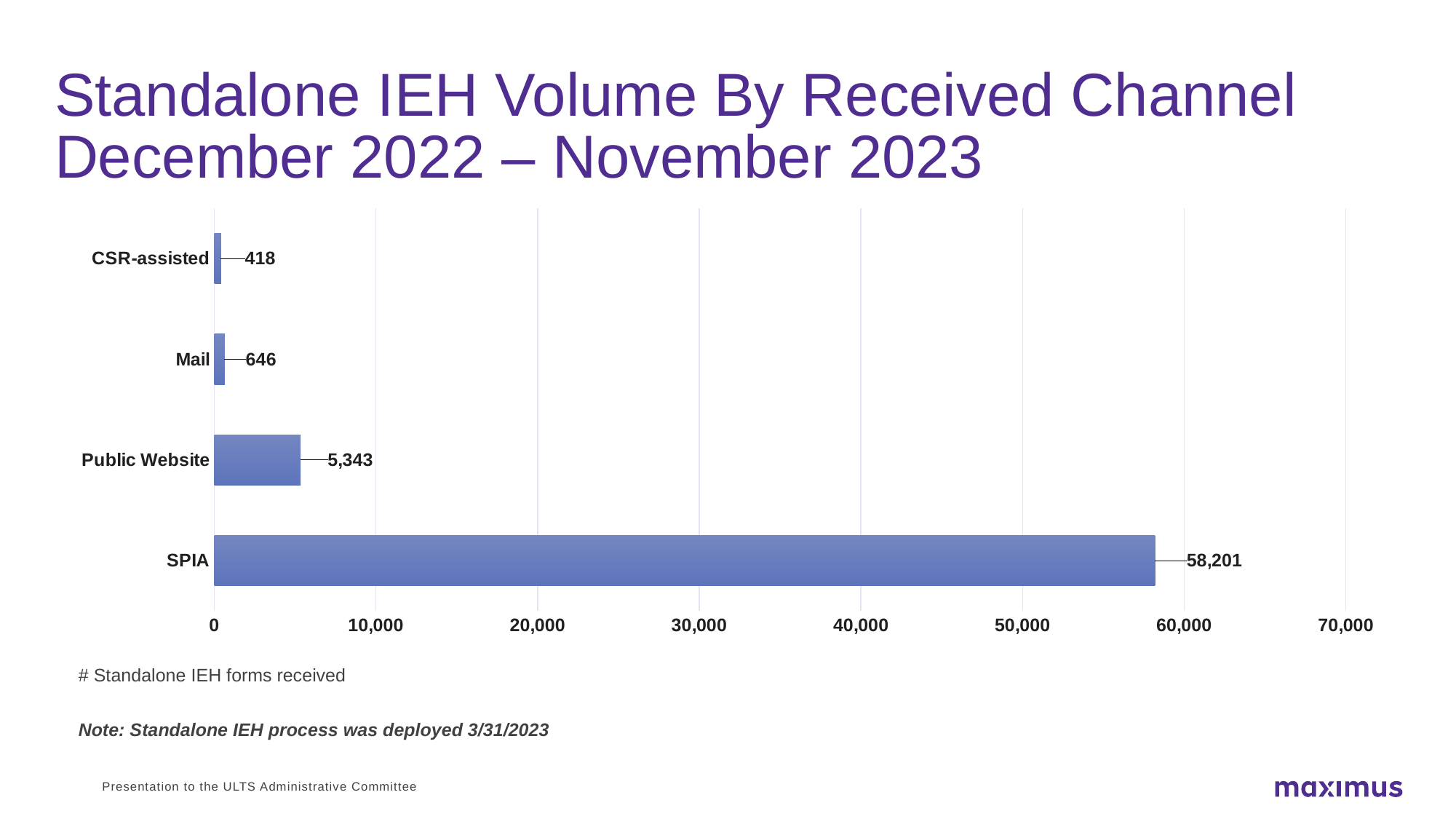
What is the value for Mail? 646 Which channel has the lowest volume? CSR-assisted What is the difference between the Mail and CSR-assisted values? 228 Which is larger, the value for Mail or the value for Public Website? Public Website What is the value for Public Website? 5,343 Is the value for SPIA greater or less than 50,000? greater Which channel has the highest volume? SPIA What is the difference between the SPIA and Public Website values? 52,858 What kind of chart is shown on the slide? Bar chart How many channels are shown in the chart? 4 What is the value for CSR-assisted? 418 What is the value for SPIA? 58,201